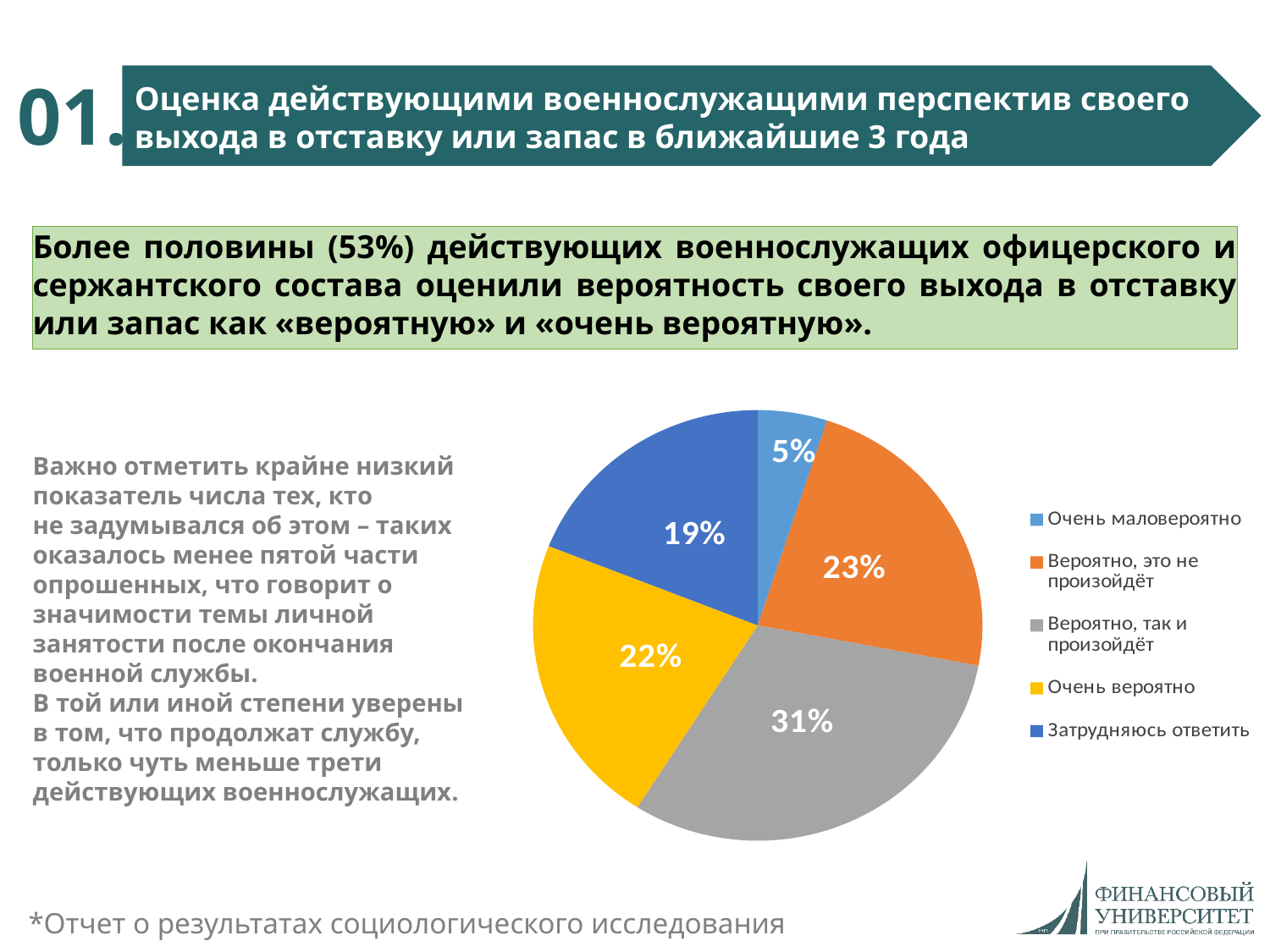
What share of respondents answered «Затрудняюсь ответить»? 19% How many slices does the pie chart have? 5 Which is larger: the share for «Очень вероятно» or the share for «Затрудняюсь ответить»? Очень вероятно What share of respondents answered «Очень маловероятно»? 5% What share of respondents answered «Очень вероятно»? 22% Which answer option has the largest share of the pie? Вероятно, так и произойдёт Which answer option has the smallest share of the pie? Очень маловероятно What is the difference between the shares for «Вероятно, так и произойдёт» and «Вероятно, это не произойдёт»? 8% What colour is the slice for «Очень вероятно»? yellow What kind of chart is shown on the slide? pie chart What share of respondents answered «Вероятно, так и произойдёт»? 31% How many entries does the legend list? 5